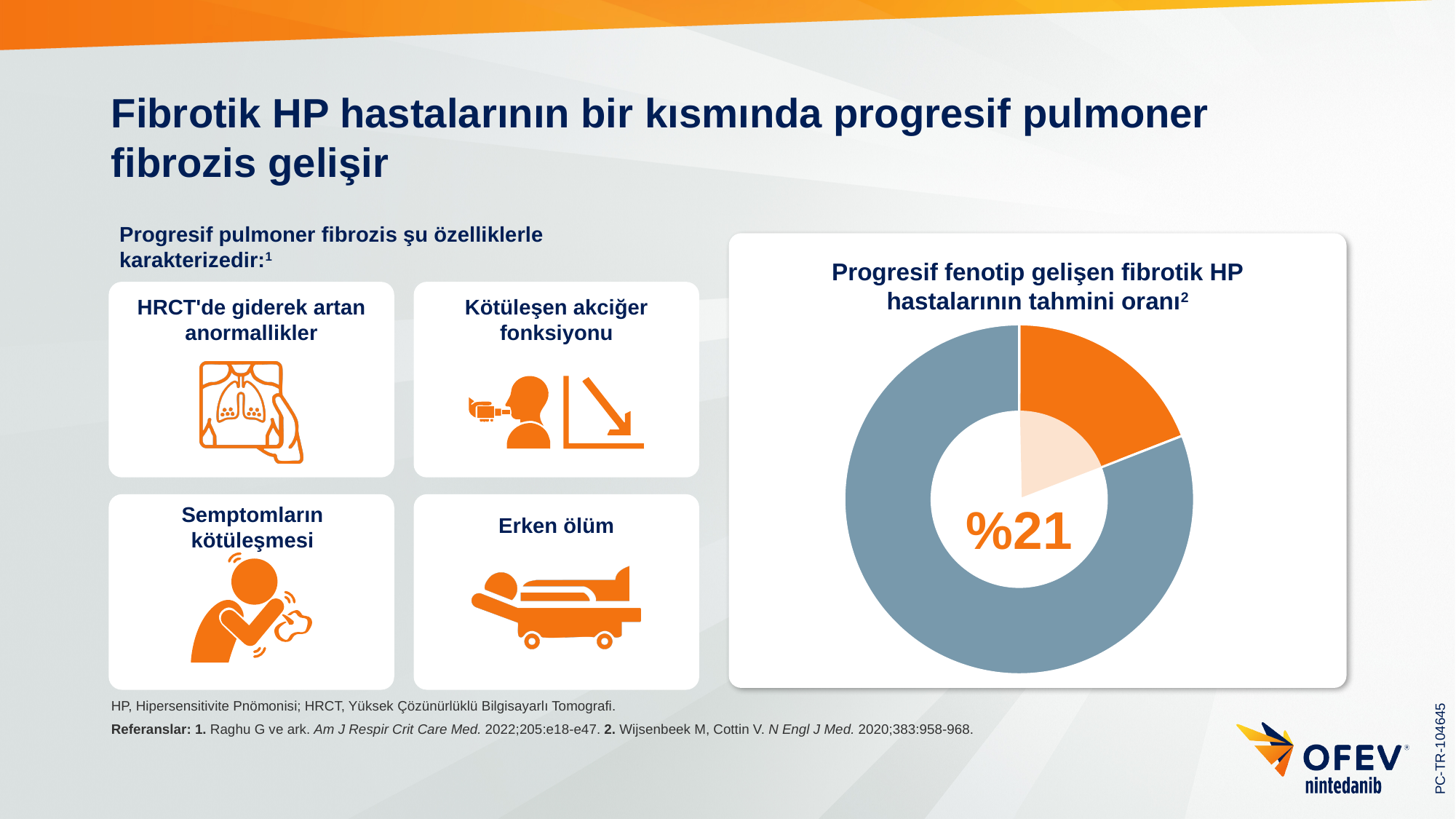
What kind of chart is shown on the right side of the slide? Pie chart (donut) What is the title of the donut chart? Progresif fenotip gelişen fibrotik HP hastalarının tahmini oranı Which slice of the donut chart is larger, the orange one or the grey-blue one? The grey-blue one What share of the donut chart does the orange slice represent? %21 Is the orange slice of the donut chart greater or less than half of the chart? less What percentage is printed in the centre of the donut chart? %21 What colour is the smaller slice of the donut chart? Orange How many slices does the donut chart have? 2